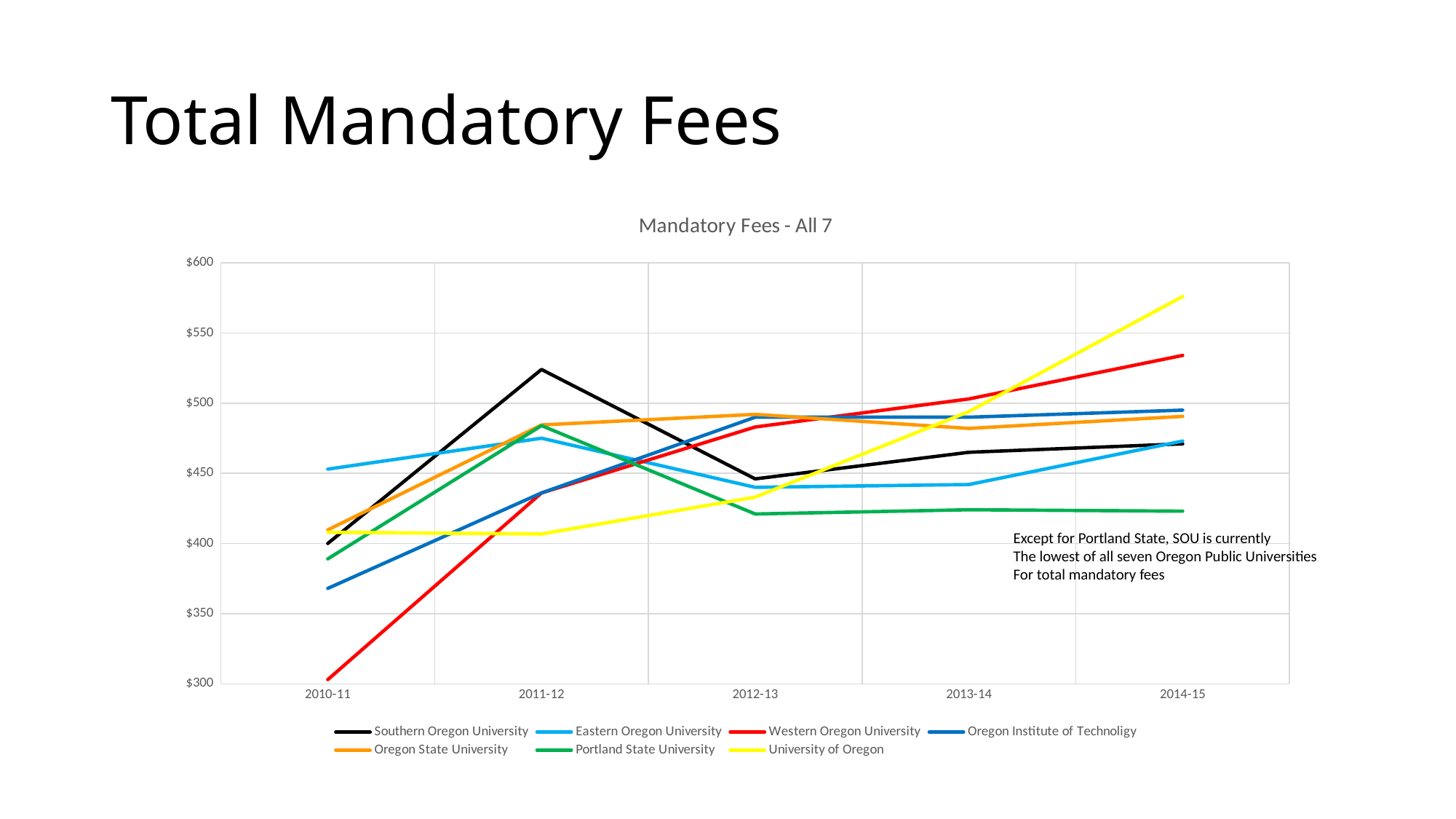
How many series does the legend list? 7 Is the value for Southern Oregon University in 2011-12 greater or less than $500? greater Is the value for University of Oregon in 2014-15 greater or less than $550? greater Which university has the highest mandatory fees in 2011-12? Southern Oregon University Which university has the highest mandatory fees in 2014-15? University of Oregon Do the mandatory fees for Western Oregon University rise or fall from 2010-11 to 2014-15? rise What kind of chart is shown on the slide? Line chart Is the value for Western Oregon University in 2010-11 greater or less than $350? less Which university has the lowest mandatory fees in 2014-15? Portland State University What is the title of the chart? Mandatory Fees - All 7 Which university has the lowest mandatory fees in 2010-11? Western Oregon University How many academic years are shown along the x axis? 5